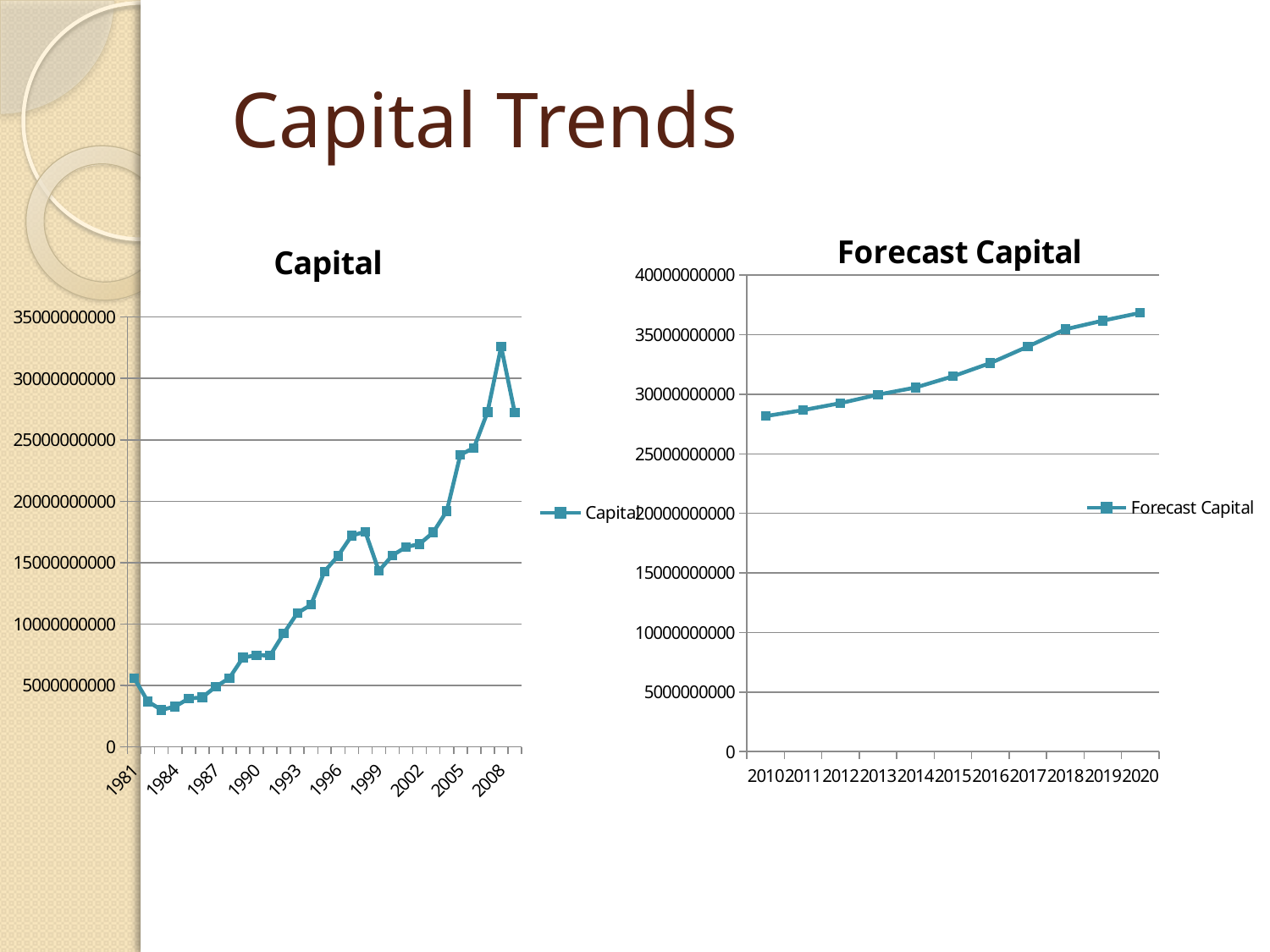
What kind of chart is the "Forecast Capital" chart on the right? line chart On the "Capital" chart, which year has the highest value? 2008 On the "Forecast Capital" chart, is the value for 2020 greater or less than 35000000000? greater On the "Capital" chart, which is larger, the value for 1981 or the value for 2008? 2008 What kind of chart is the "Capital" chart on the left? line chart On the "Forecast Capital" chart, which year has the lowest value? 2010 On the "Forecast Capital" chart, which year has the highest value? 2020 On the "Capital" chart, is the value for 1984 greater or less than 5000000000? less On the "Forecast Capital" chart, is the value for 2010 greater or less than 30000000000? less How many data points are plotted on the "Forecast Capital" chart? 11 On the "Forecast Capital" chart, do the values rise or fall from 2010 to 2020? rise How many series does the legend of the "Forecast Capital" chart list? 1